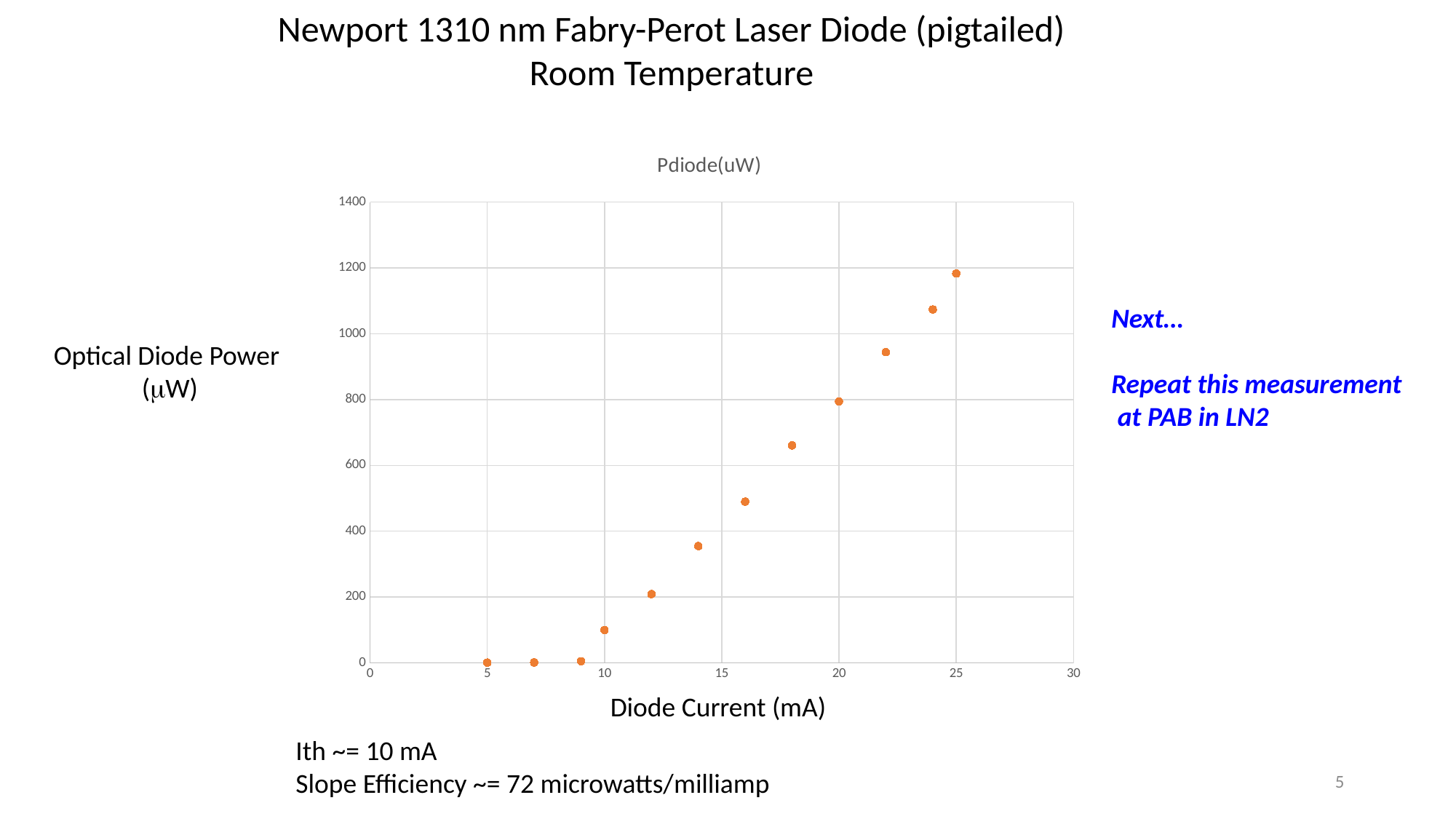
What kind of chart is shown on the slide? scatter chart Is the value at 20 mA greater or less than 600? greater At which diode current is the plotted power highest? 25 mA Is the value at 18 mA greater or less than 800? less Is the value at 16 mA greater or less than 400? greater What is the label of the x axis of the chart? Diode Current (mA) Do the plotted values rise or fall as diode current increases along the x axis? rise How many data points are plotted on the chart? 12 Which has the larger plotted power, 14 mA or 20 mA? 20 mA What is the title of the chart? Pdiode(uW)